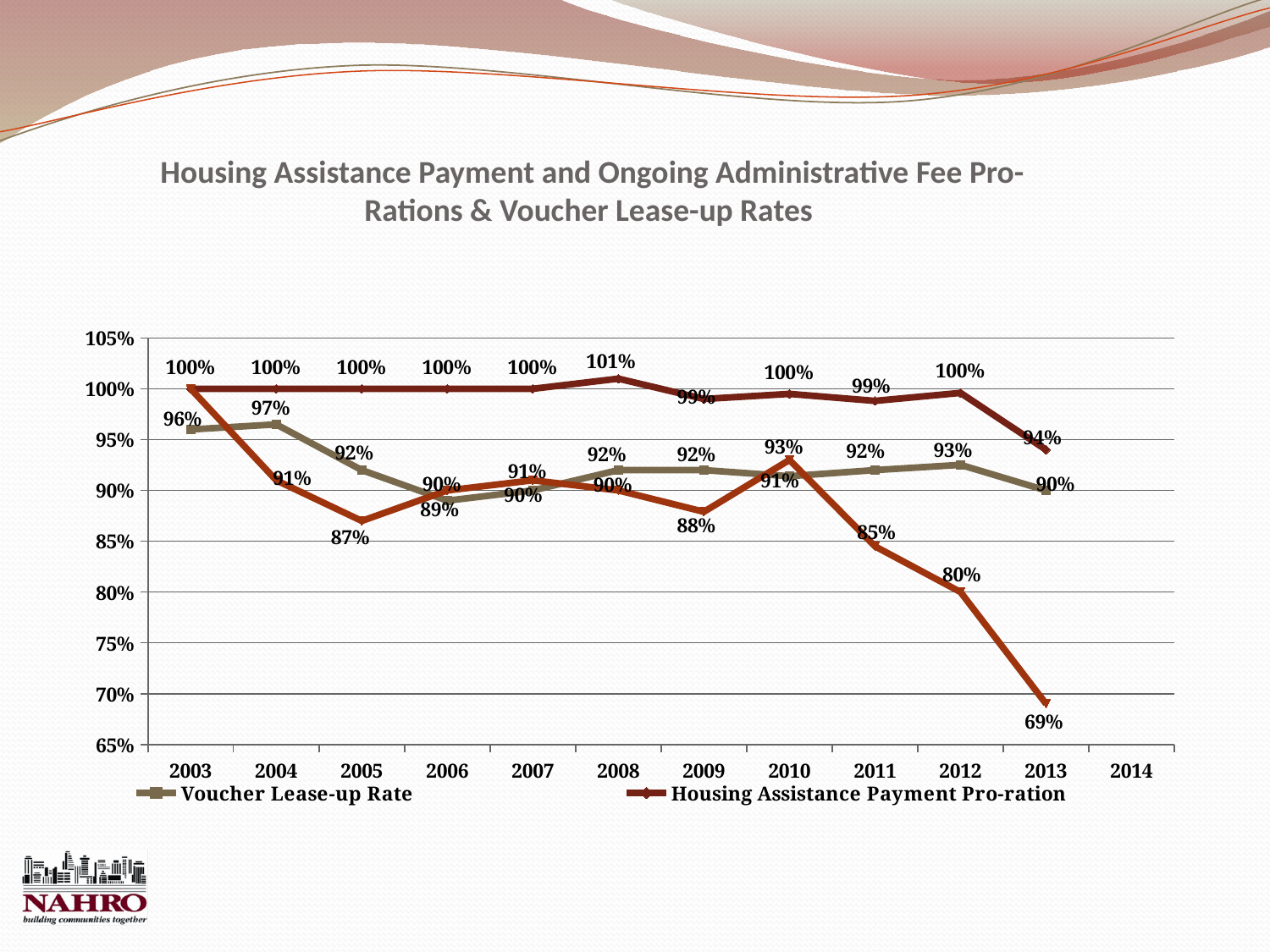
How many series does the legend list? 2 By how many percentage points did the Housing Assistance Payment Pro-ration fall from 2012 to 2013? 6 percentage points In which year is the Voucher Lease-up Rate highest? 2004 Does the Housing Assistance Payment Pro-ration rise or fall from 2010 to 2013? fall What is the Housing Assistance Payment Pro-ration value for 2013? 94% In 2011, which is larger: the Voucher Lease-up Rate or the Housing Assistance Payment Pro-ration? Housing Assistance Payment Pro-ration What is the Voucher Lease-up Rate for 2012? 93% What is the Housing Assistance Payment Pro-ration value for 2005? 100% What is the Voucher Lease-up Rate for 2004? 97% In which year is the Housing Assistance Payment Pro-ration lowest? 2013 What kind of chart is shown on the slide? line chart Is the Housing Assistance Payment Pro-ration for 2012 greater or less than 85%? greater